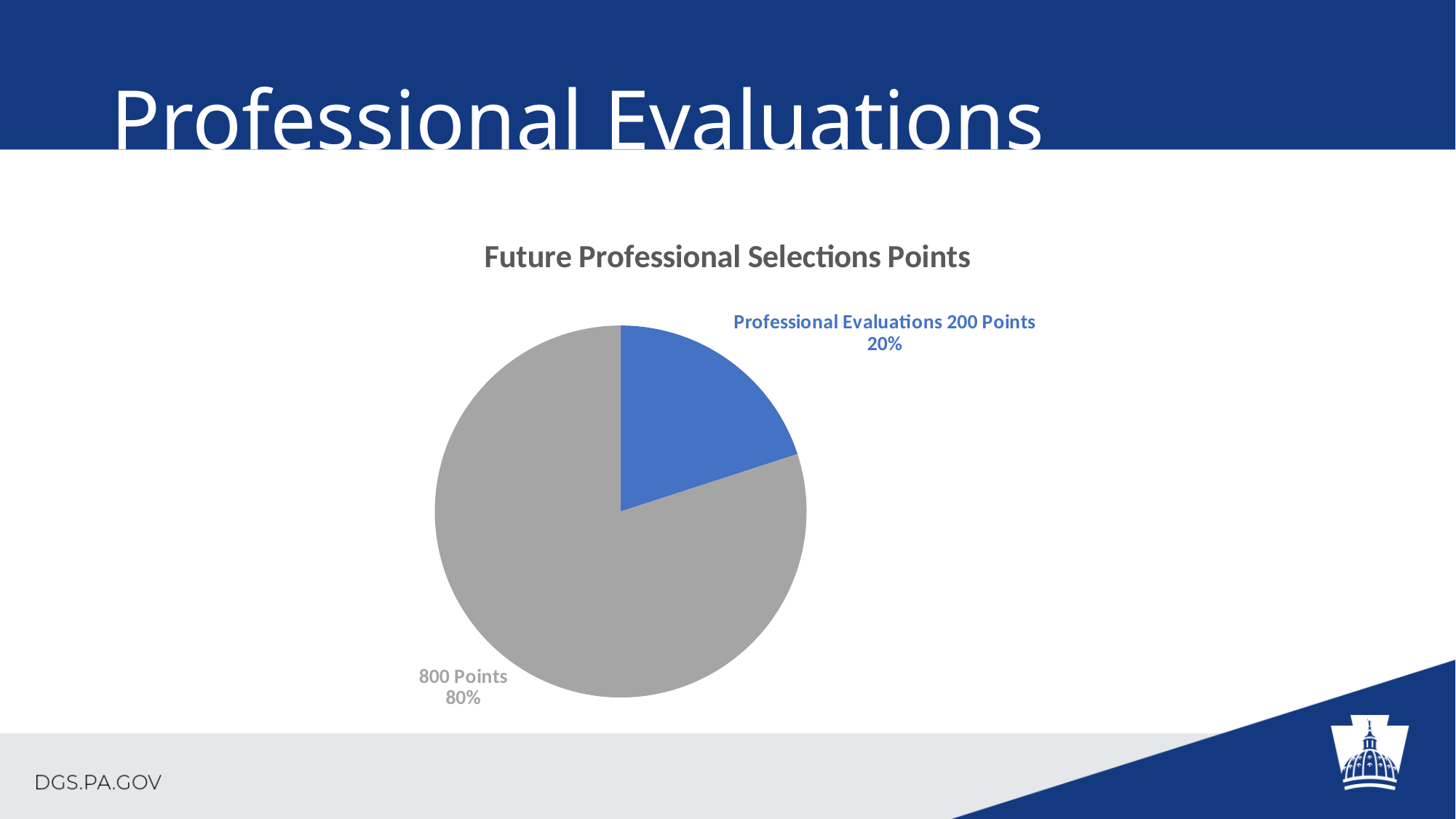
How many slices does the pie chart have? 2 How many points are assigned to Professional Evaluations? 200 Points Which slice is the largest in the pie chart? 800 Points What is the total number of points represented by the whole pie? 1000 Points What is the difference in points between the 800 Points slice and the Professional Evaluations slice? 600 Points What kind of chart is shown on the slide? Pie chart What share of the pie does the 800 Points slice represent? 80% What share of the pie does the Professional Evaluations slice represent? 20% What is the title of the chart? Future Professional Selections Points How many points does the larger grey slice represent? 800 Points Which slice is the smallest in the pie chart? Professional Evaluations 200 Points What colour is the Professional Evaluations slice? Blue